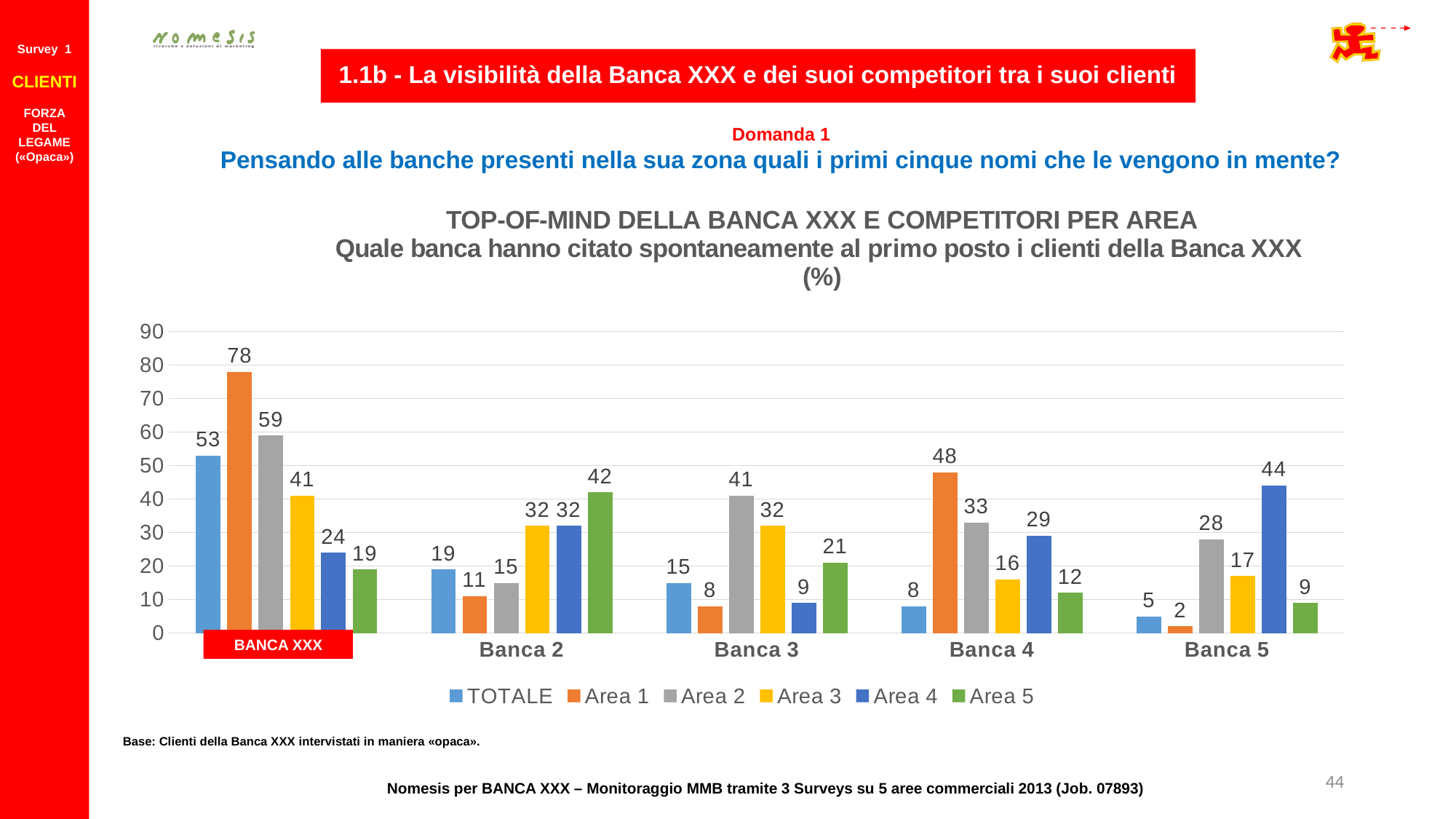
Which bank has the lowest TOTALE value? Banca 5 Which is larger for Banca 3: the Area 2 value or the Area 3 value? Area 2 Which bank has the highest Area 2 value? BANCA XXX What kind of chart is shown on the slide? Bar chart What is the Area 1 value for Banca 4? 48 What is the Area 4 value for Banca 5? 44 What is the TOTALE value for BANCA XXX? 53 Which series is shown in orange in the legend? Area 1 What is the difference between the Area 1 value for BANCA XXX and the Area 1 value for Banca 4? 30 How many banks are shown on the x axis? 5 How many series does the legend list? 6 Is the Area 5 value for Banca 2 greater or less than 40? greater